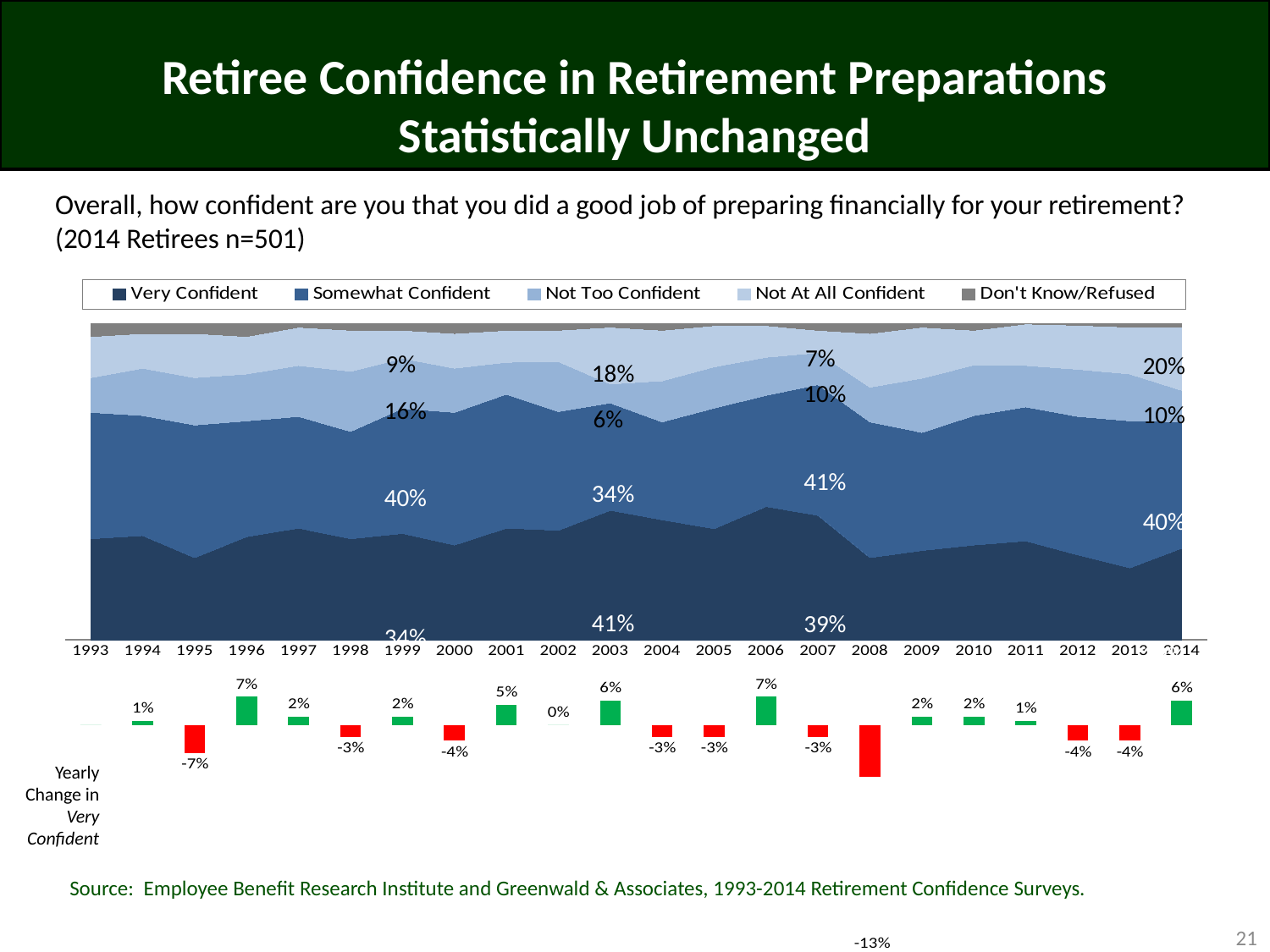
In the bottom chart of yearly change in Very Confident, what is the value for 1995? -7% In the top chart, what is the difference between the Somewhat Confident share and the Not Too Confident share in 2007? 31 percentage points In the top chart, what percentage of retirees were Very Confident in 2003? 41% In the bottom chart of yearly change in Very Confident, what is the value for 1996? 7% In the top chart, what percentage of retirees were Somewhat Confident in 2007? 41% How many years are shown along the x axis of the top chart? 22 What kind of chart is the top chart showing confidence levels from 1993 to 2014? Stacked area chart In the top chart, which was larger in 2003: the Very Confident share or the Somewhat Confident share? Very Confident In the bottom chart of yearly change in Very Confident, what is the value for 2014? 6% In the bottom chart of yearly change in Very Confident, which year has the lowest value? 2008 How many series does the legend of the top chart list? 5 In the top chart, what percentage of retirees were Not At All Confident in 2014? 20%